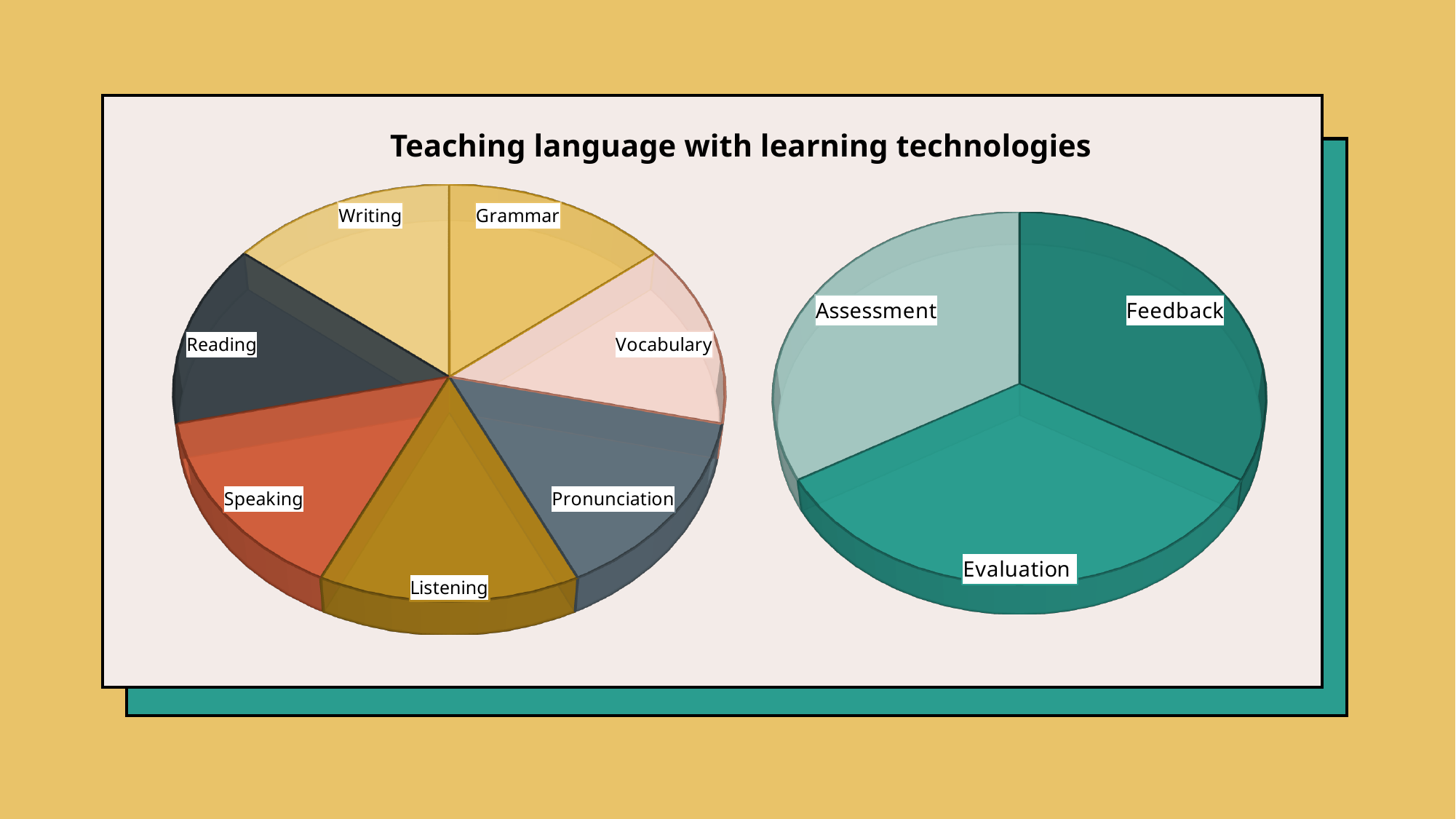
In the pie chart on the left of the slide, which slice is labelled directly to the right of the Grammar slice? Vocabulary In the pie chart on the right of the slide, which slice is labelled between Assessment and Feedback at the bottom? Evaluation How many charts are shown on the slide? 2 How many slices does the pie chart on the left of the slide have? 7 What is the title shown at the top of the slide above the charts? Teaching language with learning technologies What kind of chart is the chart on the left of the slide? pie chart What kind of chart is the chart on the right of the slide? pie chart How many slices does the pie chart on the right of the slide have? 3